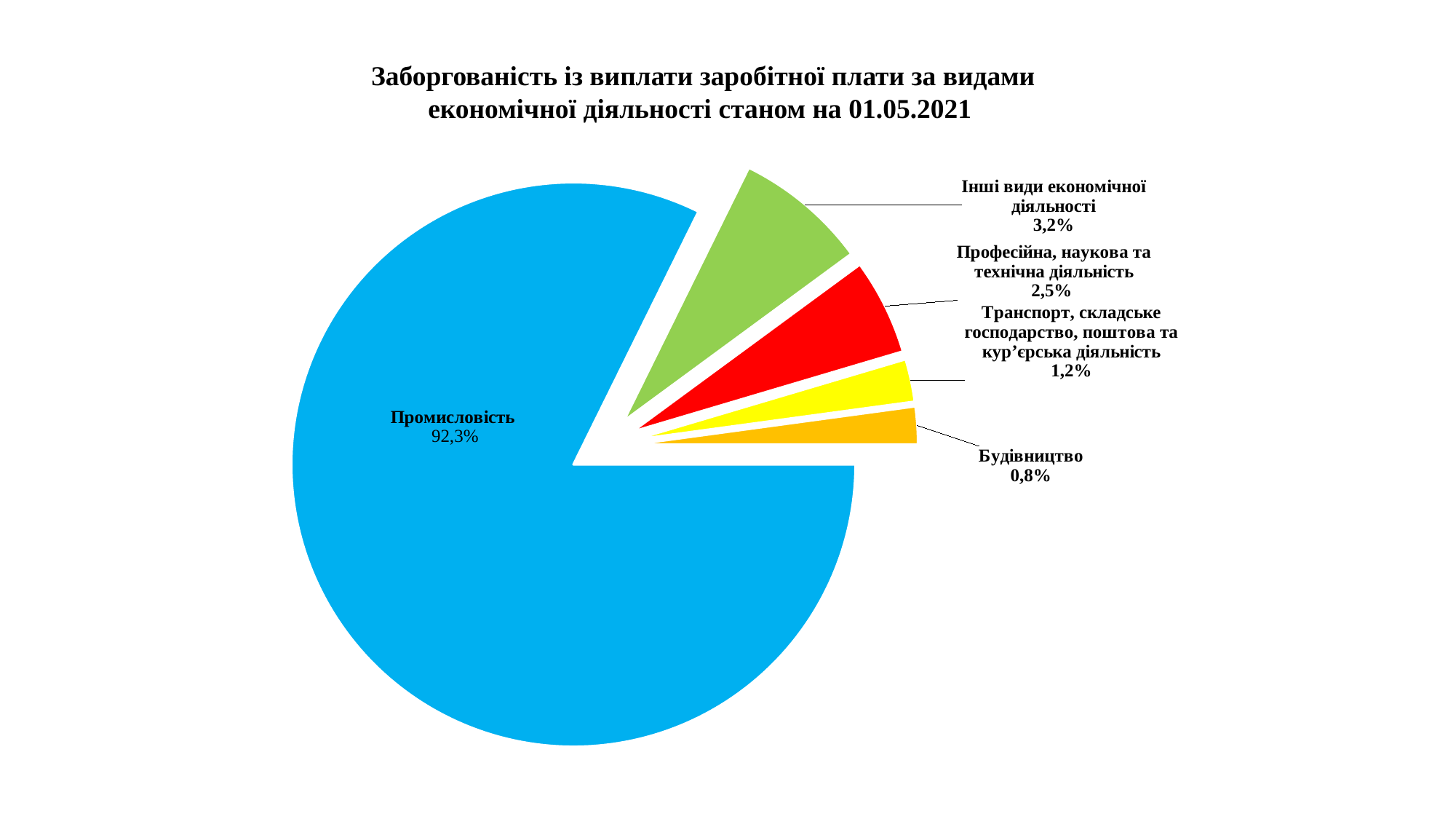
What share does Промисловість have in the pie? 92,3% Which is larger: the share of Транспорт, складське господарство, поштова та кур’єрська діяльність or the share of Будівництво? Транспорт, складське господарство, поштова та кур’єрська діяльність What is the value for Транспорт, складське господарство, поштова та кур’єрська діяльність? 1,2% What is the value for Будівництво? 0,8% What is the value for Інші види економічної діяльності? 3,2% What kind of chart is shown on the slide? pie chart What is the value for Професійна, наукова та технічна діяльність? 2,5% What is the difference between the shares of Інші види економічної діяльності and Професійна, наукова та технічна діяльність? 0,7% What colour is the Промисловість slice? blue Which category has the largest share of the pie? Промисловість How many categories are shown in the pie chart? 5 Which category has the smallest share of the pie? Будівництво